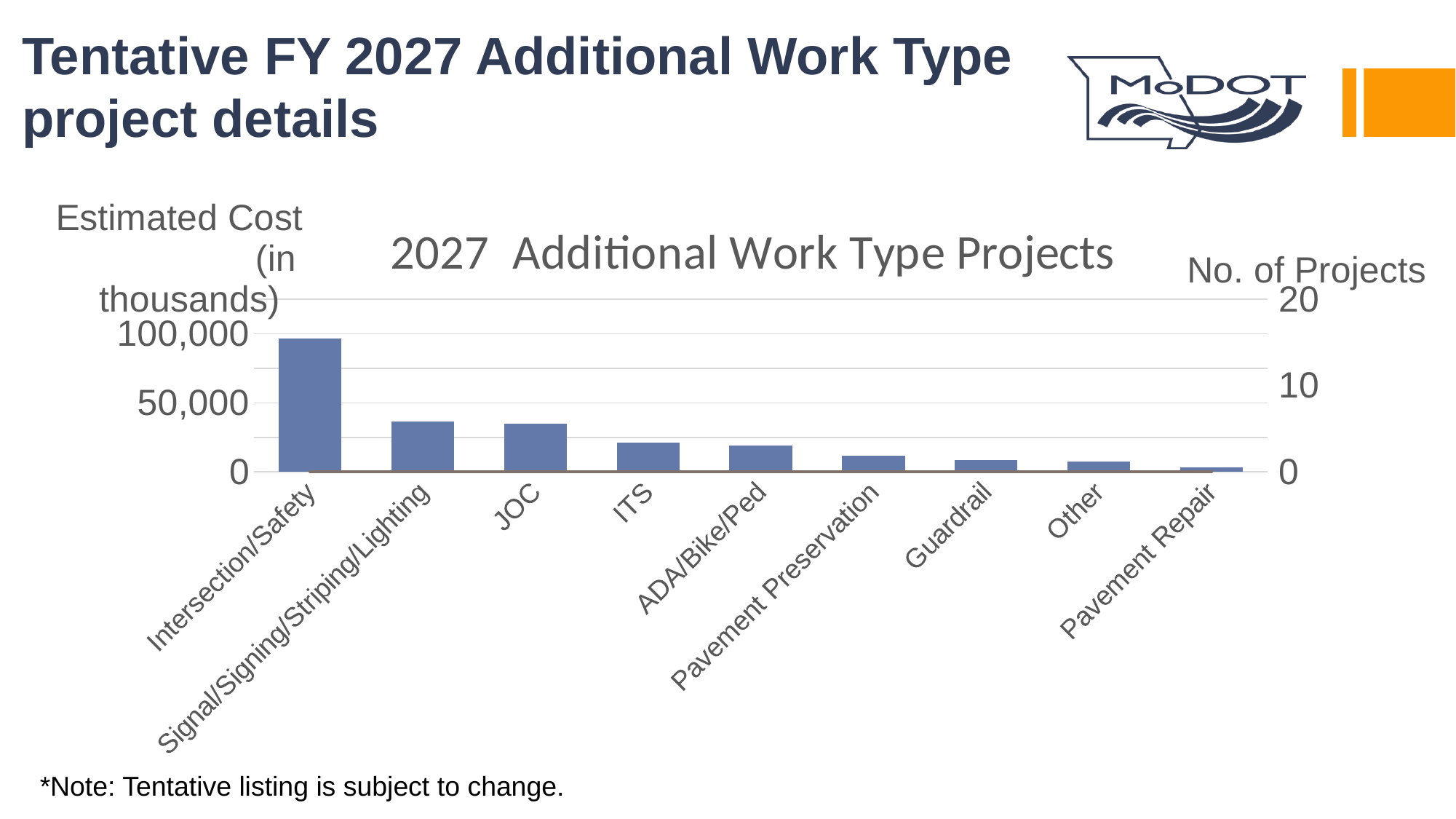
Is the estimated cost for Intersection/Safety greater or less than 50,000? greater Do the bar values rise or fall moving from left to right along the x axis? fall What is the title of the chart? 2027 Additional Work Type Projects What kind of chart is shown on the slide? bar chart Which has the larger estimated cost, Intersection/Safety or JOC? Intersection/Safety Which has the larger estimated cost, ITS or Guardrail? ITS Which work type has the lowest estimated cost in the chart? Pavement Repair What is the label of the left vertical axis of the chart? Estimated Cost (in thousands) Is the estimated cost for Signal/Signing/Striping/Lighting greater or less than 50,000? less Which work type has the highest estimated cost in the chart? Intersection/Safety Is the estimated cost for JOC greater or less than 50,000? less How many work type categories are shown on the x axis of the chart? 9